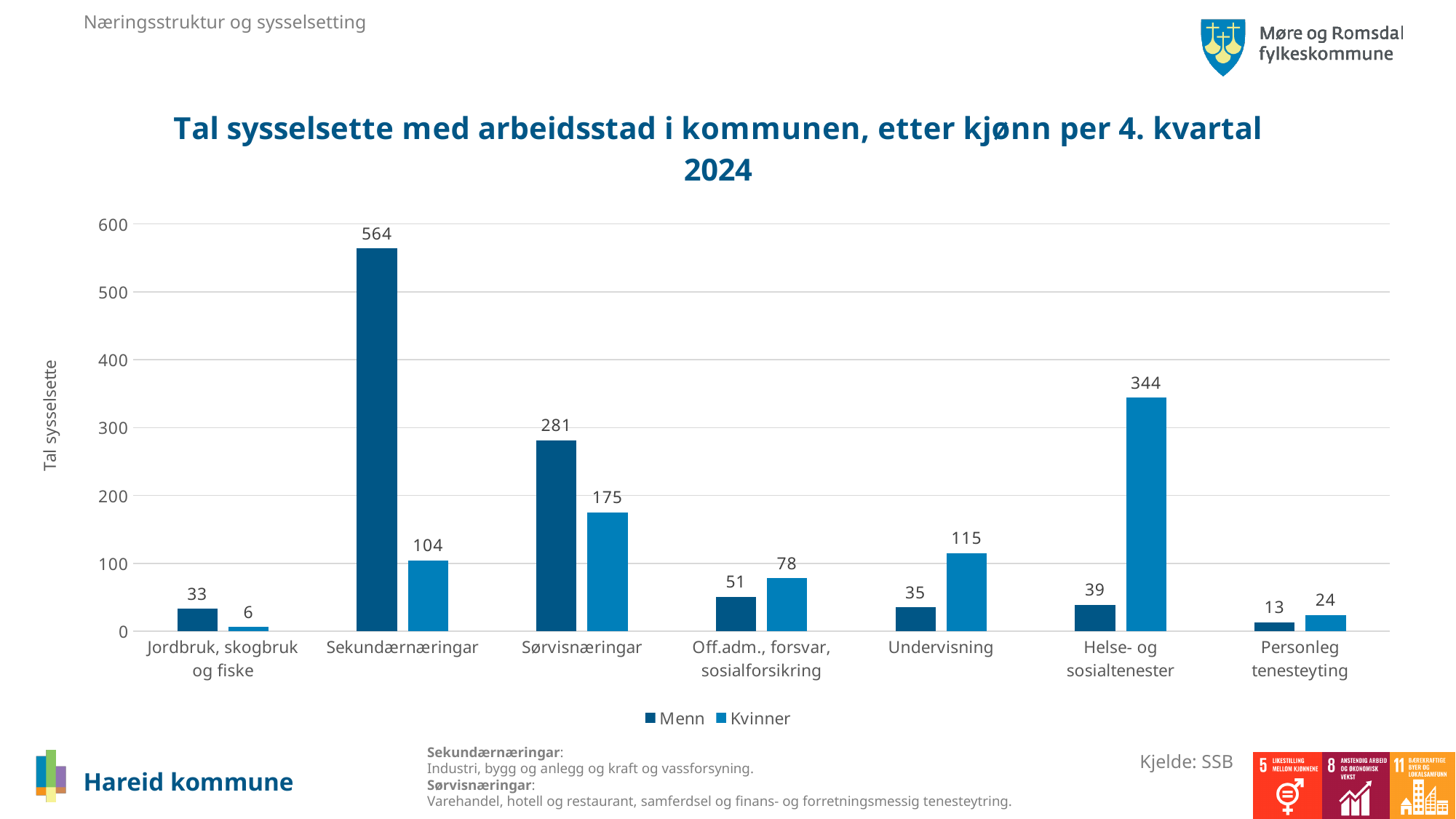
How many series does the legend list? 2 How many categories are shown on the x axis? 7 What is the difference between Menn and Kvinner in Sørvisnæringar? 106 What is the value for Kvinner in Helse- og sosialtenester? 344 What is the value for Menn in Sekundærnæringar? 564 What kind of chart is shown on the slide? bar chart What is the label of the y axis? Tal sysselsette Is the value for Kvinner in Sekundærnæringar greater or less than 200? less What is the value for Kvinner in Jordbruk, skogbruk og fiske? 6 Which category has the highest value for Menn? Sekundærnæringar In Undervisning, which is larger, Menn or Kvinner? Kvinner Which category has the lowest value for Kvinner? Jordbruk, skogbruk og fiske